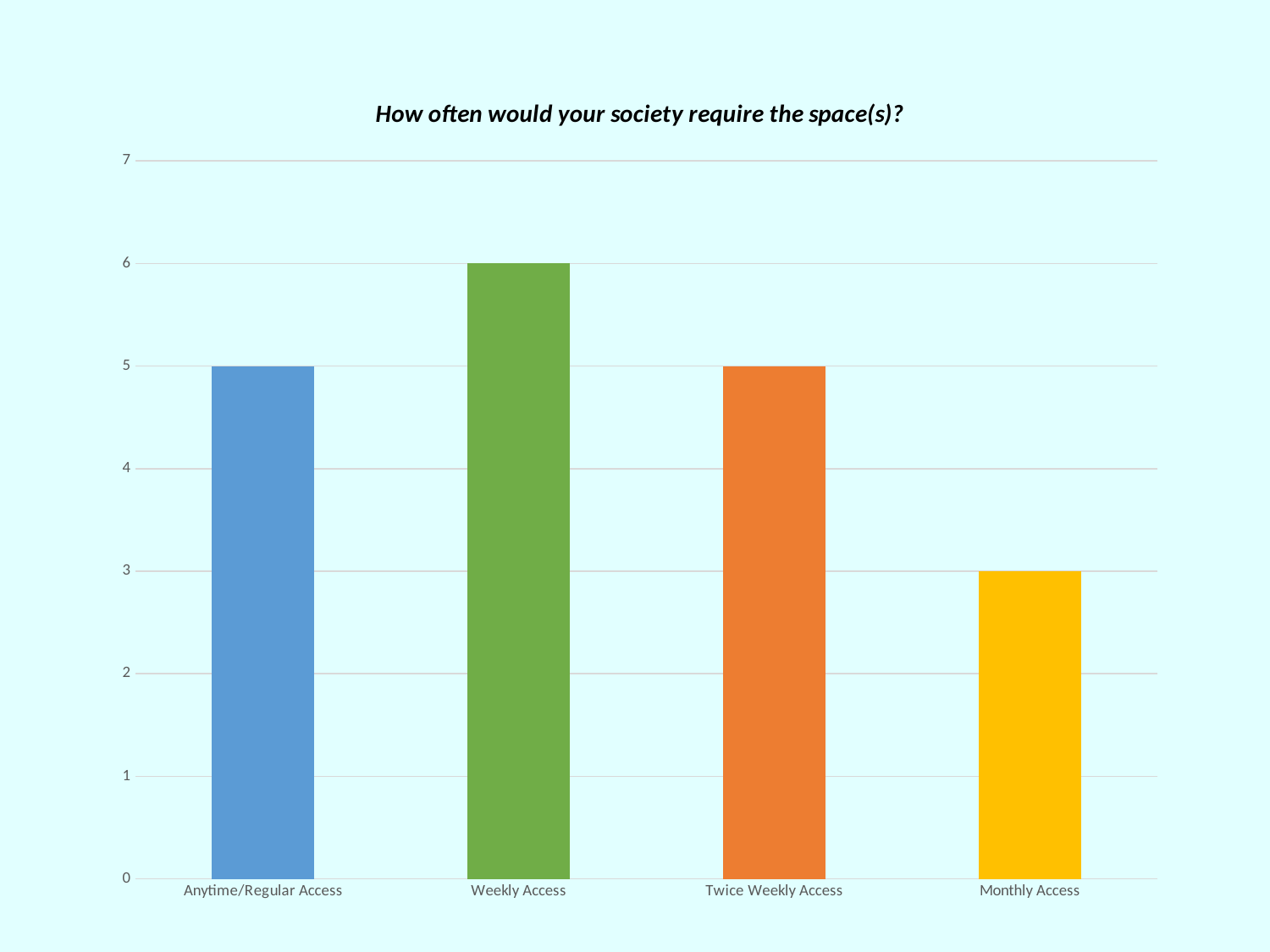
What kind of chart is shown on the slide? bar chart What is the value for Anytime/Regular Access? 5 What is the value for Weekly Access? 6 What is the difference between the values for Weekly Access and Monthly Access? 3 What is the value for Twice Weekly Access? 5 What is the value for Monthly Access? 3 Which is larger, the value for Weekly Access or the value for Monthly Access? Weekly Access Which category has the lowest value? Monthly Access Is the value for Monthly Access greater or less than 4? less How many categories are shown on the x axis? 4 What is the title of the chart? How often would your society require the space(s)? Which category has the highest value? Weekly Access